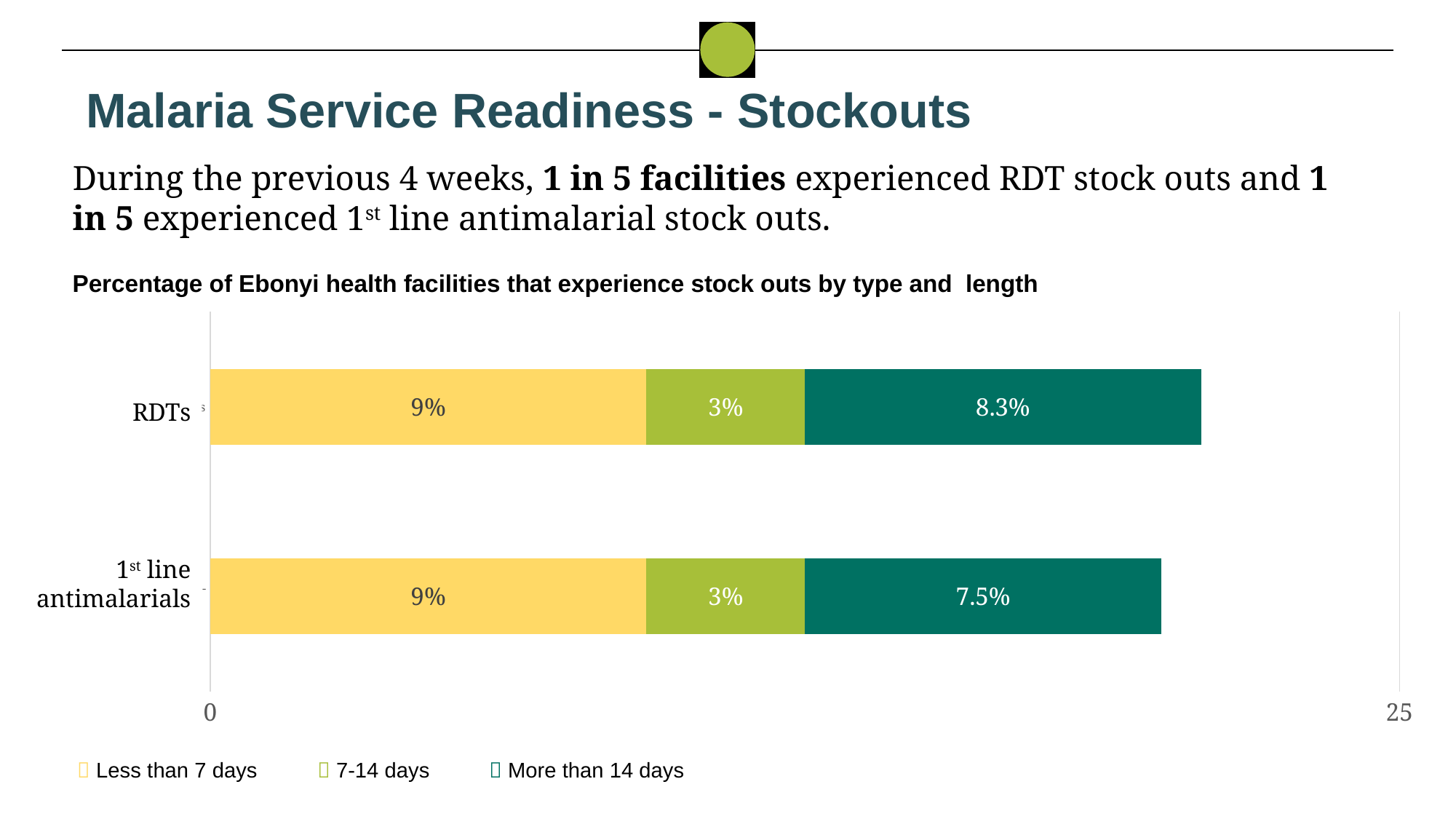
What is the value for 1st line antimalarials in the '7-14 days' series? 3% What percentage of facilities experienced RDT stock outs of more than 14 days? 8.3% What is the value for RDTs in the 'Less than 7 days' series? 9% What is the title of the chart? Percentage of Ebonyi health facilities that experience stock outs by type and length How many series does the legend list? 3 Is the total length of the RDTs bar greater or less than 25? less What percentage of facilities experienced 1st line antimalarial stock outs of more than 14 days? 7.5% Which category has the larger value for 'More than 14 days', RDTs or 1st line antimalarials? RDTs How many categories are plotted on the chart? 2 What is the difference between the 'More than 14 days' values for RDTs and 1st line antimalarials? 0.8% What is the total of the stacked bar for 1st line antimalarials? 19.5% What kind of chart is shown on the slide? Stacked bar chart